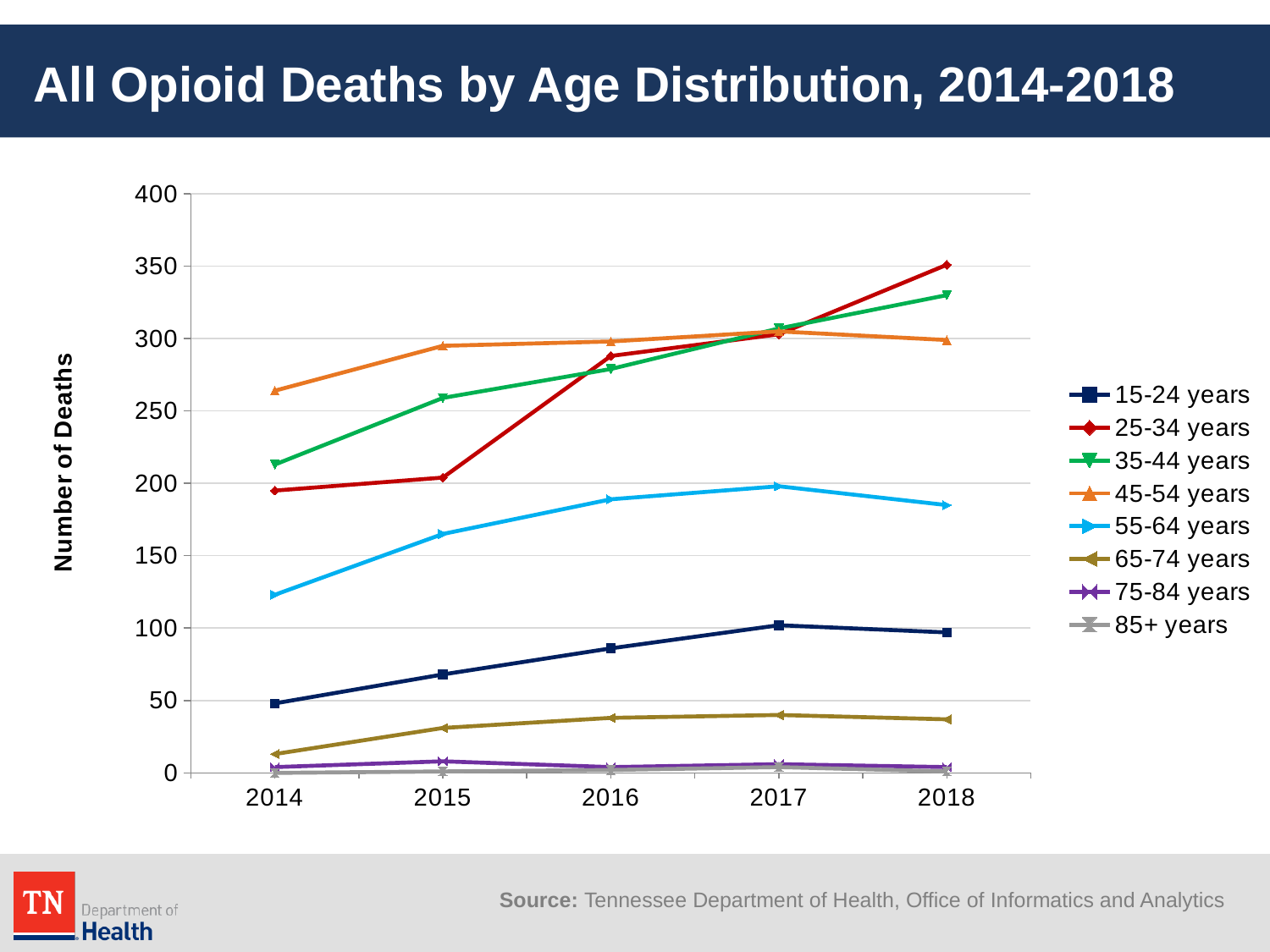
How many age groups does the legend list? 8 In 2018, which had more opioid deaths: 35-44 years or 45-54 years? 35-44 years What is the label on the y axis? Number of Deaths Is the value for 15-24 years in 2016 greater or less than 100? less Which age group had the highest number of opioid deaths in 2018? 25-34 years Do the values for 25-34 years rise or fall from 2014 to 2018? rise Is the value for 55-64 years in 2014 greater or less than 150? less Which age group had the highest number of opioid deaths in 2014? 45-54 years Is the value for 25-34 years in 2018 greater or less than 300? greater How many years are plotted along the x axis? 5 What kind of chart is shown on the slide? line chart Which age group had the lowest number of opioid deaths in 2018? 85+ years